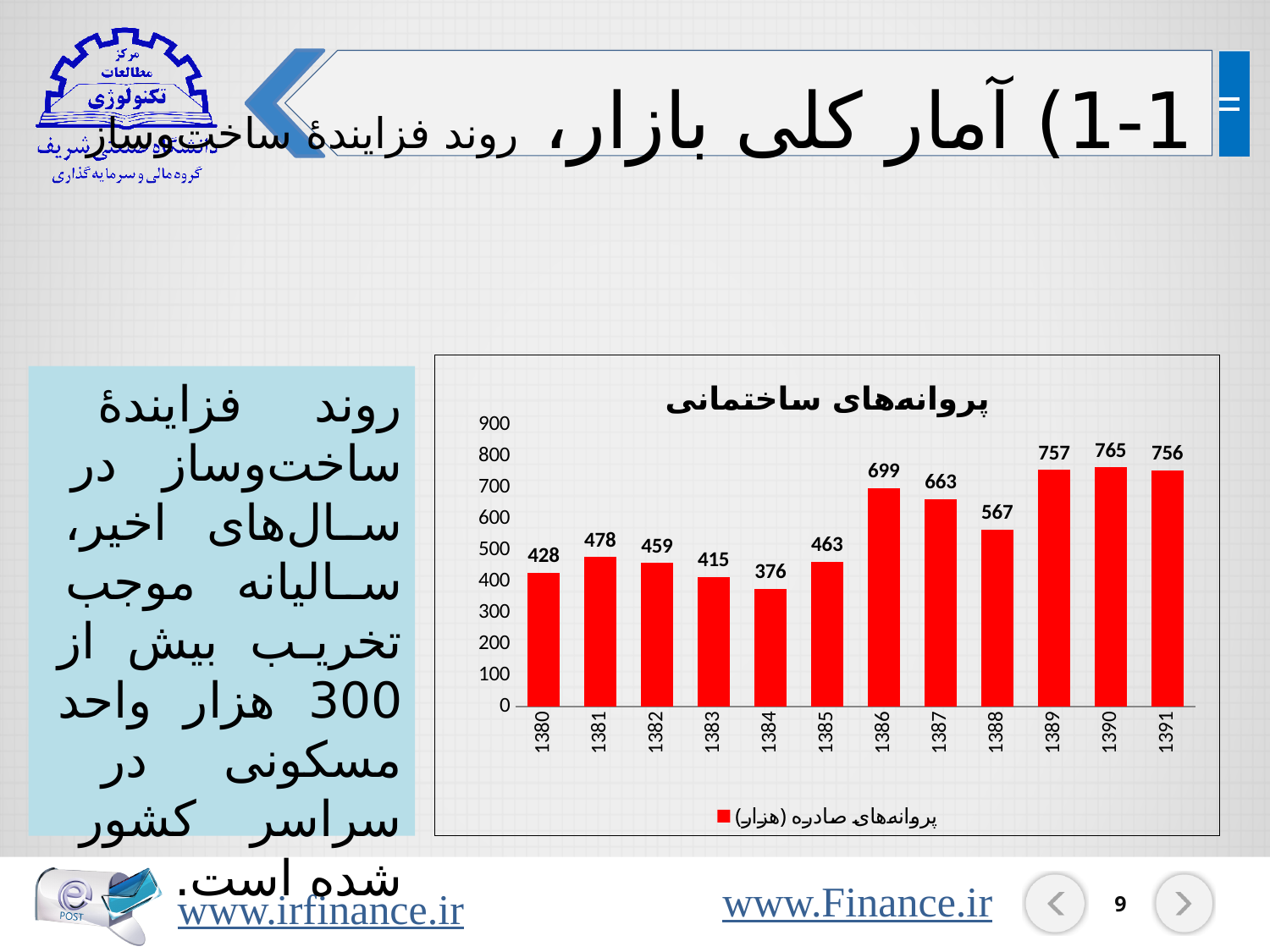
What is the difference between the values for 1390 and 1384? 389 What is the difference between the values for 1386 and 1387? 36 How many years are shown on the x axis of the chart? 12 What is the value for 1386 in the building permits chart? 699 How many series does the chart legend list? 1 Which year has the highest value in the building permits chart? 1390 What kind of chart is shown on the slide? bar chart Which year has the lowest value in the building permits chart? 1384 What is the value for 1388 in the building permits chart? 567 What is the value for 1380 in the building permits chart? 428 Which is larger, the value for 1381 or the value for 1383? 1381 Is the value for 1389 greater or less than 700? greater